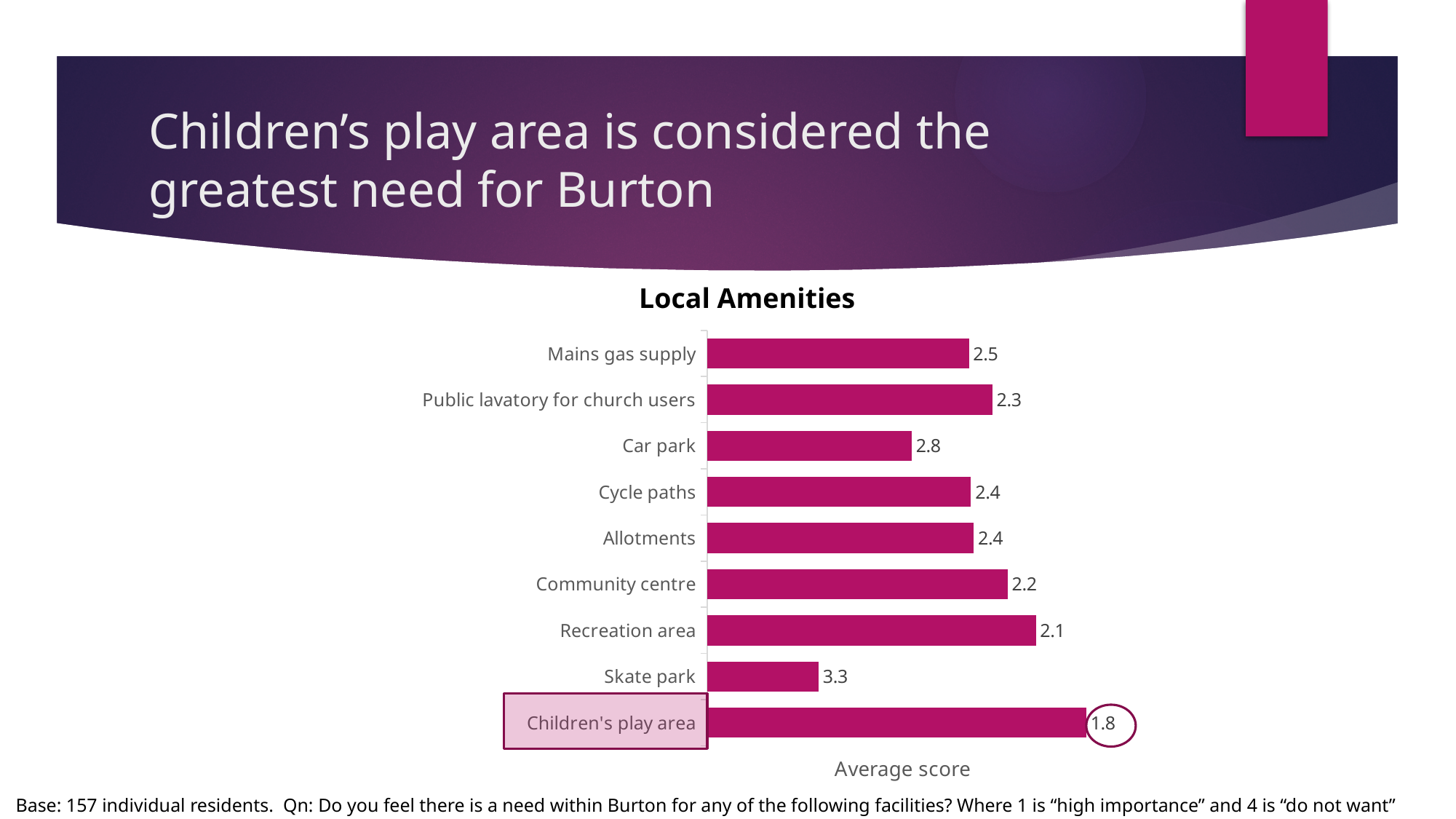
Which category has the lowest average score according to the data labels? Children's play area What is the average score for Skate park? 3.3 What type of chart is shown on the slide? Bar chart What is the title of the chart? Local Amenities What is the difference between the labelled average scores for Skate park and Children's play area? 1.5 What is the average score for Public lavatory for church users? 2.3 What is the average score for Mains gas supply? 2.5 How many categories are shown in the chart? 9 Which category has the highest average score according to the data labels? Skate park What is the average score for Children's play area? 1.8 What is the average score for Recreation area? 2.1 Which has the larger labelled average score, Car park or Cycle paths? Car park